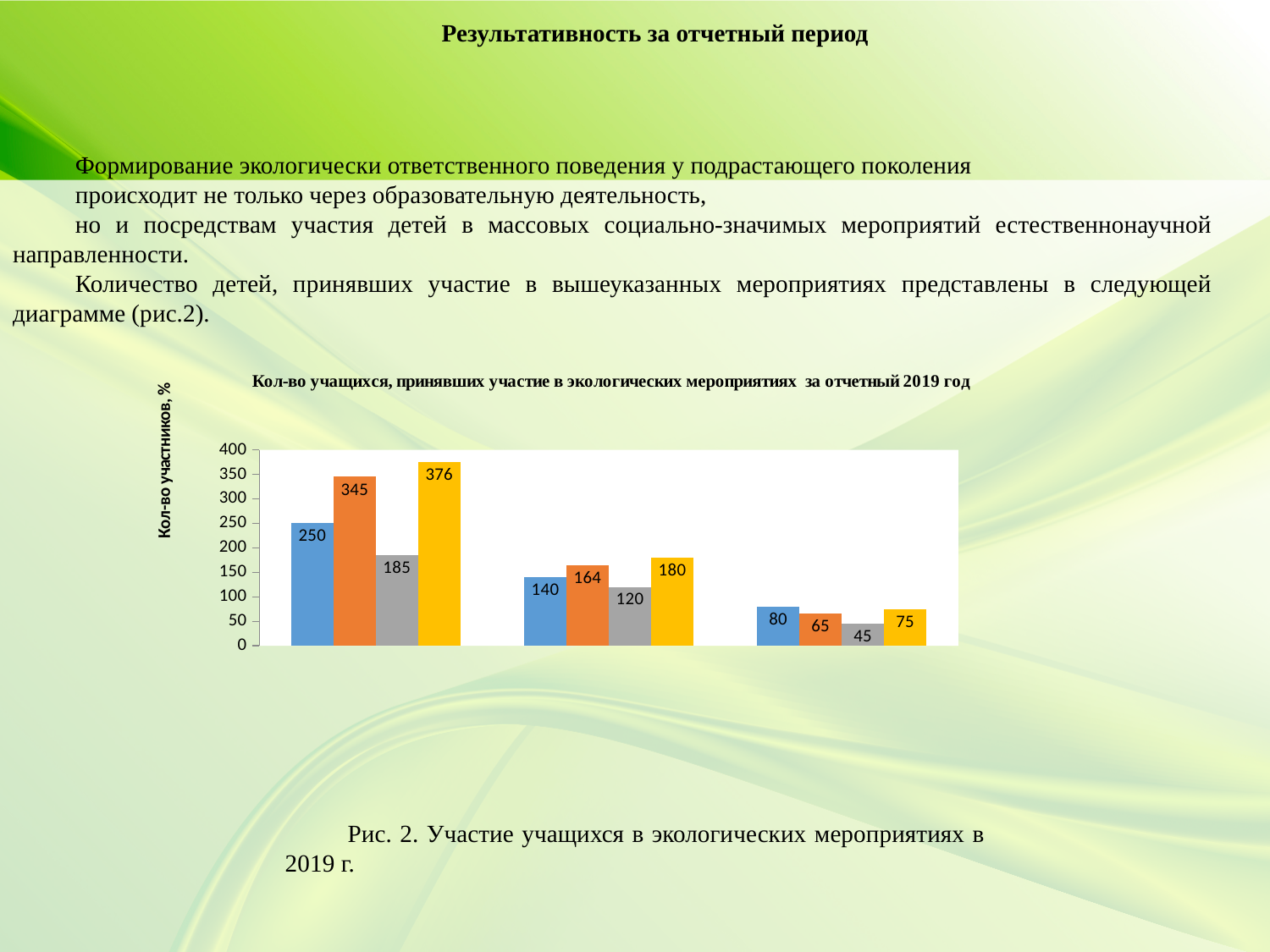
Which is larger in the third group: the blue bar or the yellow bar? the blue bar (80) What is the title of the chart? Кол-во учащихся, принявших участие в экологических мероприятиях за отчетный 2019 год What is the difference between the orange bar and the blue bar in the first group? 95 What is the value of the yellow bar in the first (leftmost) group? 376 Which bar has the lowest value in the whole chart? the gray bar in the third group (45) How many groups of bars does the chart contain? 3 What is the value of the gray bar in the second (middle) group? 120 Which bar has the highest value in the whole chart? the yellow bar in the first group (376) What is the label of the vertical axis? Кол-во участников, % What kind of chart is shown on the slide? bar chart How many bars are in each group of the chart? 4 What is the value of the orange bar in the third (rightmost) group? 65